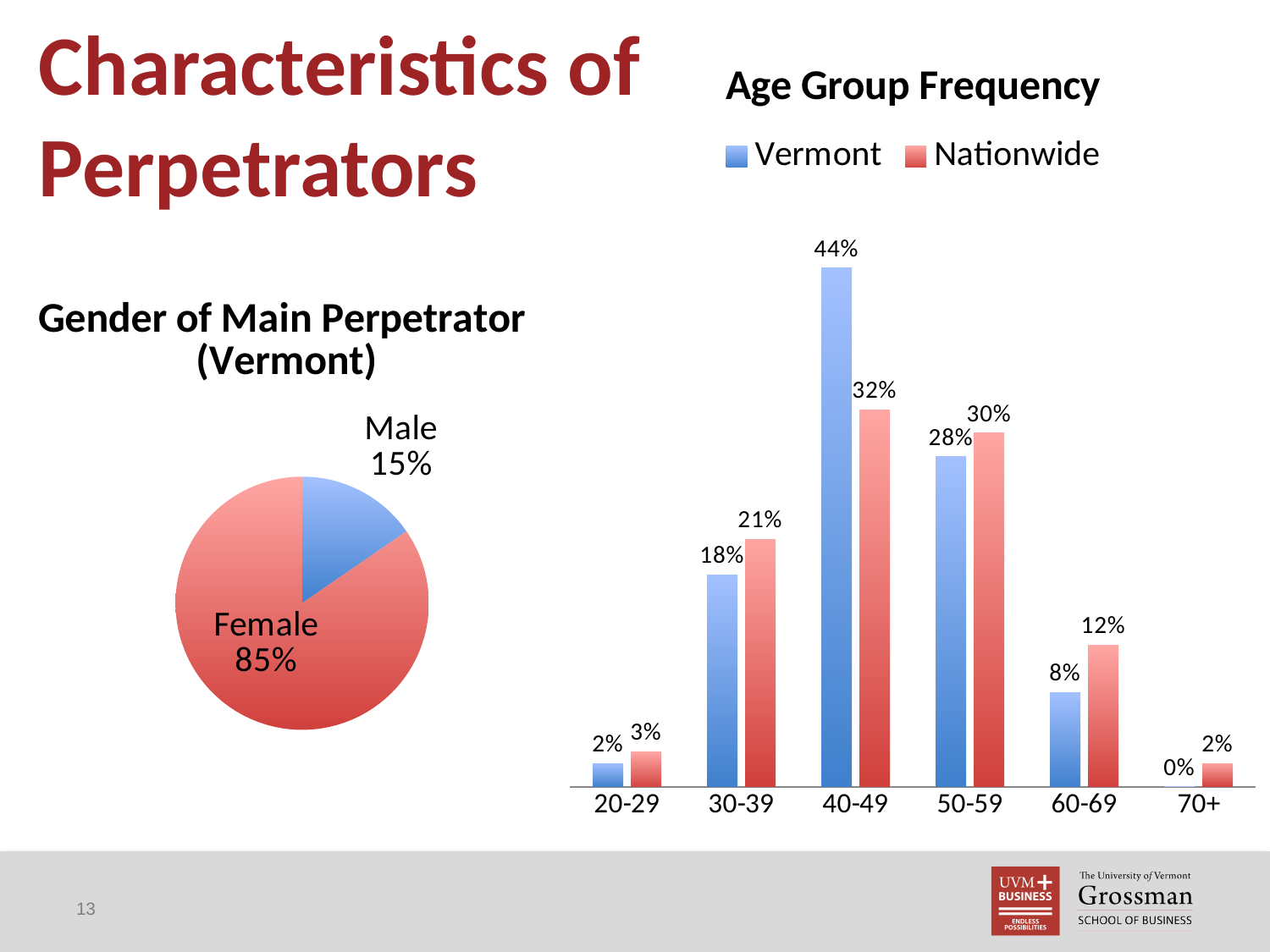
How many series does the legend of the Age Group Frequency chart list? 2 In the Age Group Frequency chart, which is larger for the 50-59 age group, Vermont or Nationwide? Nationwide In the Age Group Frequency chart, what is the Nationwide value for the 60-69 age group? 12% How many age groups are shown in the Age Group Frequency chart? 6 In the Age Group Frequency chart, which colour represents the Vermont series? Blue What kind of chart is the Gender of Main Perpetrator (Vermont) chart? Pie chart In the Gender of Main Perpetrator (Vermont) chart, what share of the pie is Female? 85% In the Age Group Frequency chart, which age group has the highest Vermont value? 40-49 What kind of chart is the Age Group Frequency chart? Bar chart In the Age Group Frequency chart, what is the difference between the Vermont and Nationwide values for the 40-49 age group? 12% In the Age Group Frequency chart, what is the Vermont value for the 40-49 age group? 44% In the Age Group Frequency chart, which age group has the lowest Nationwide value? 70+